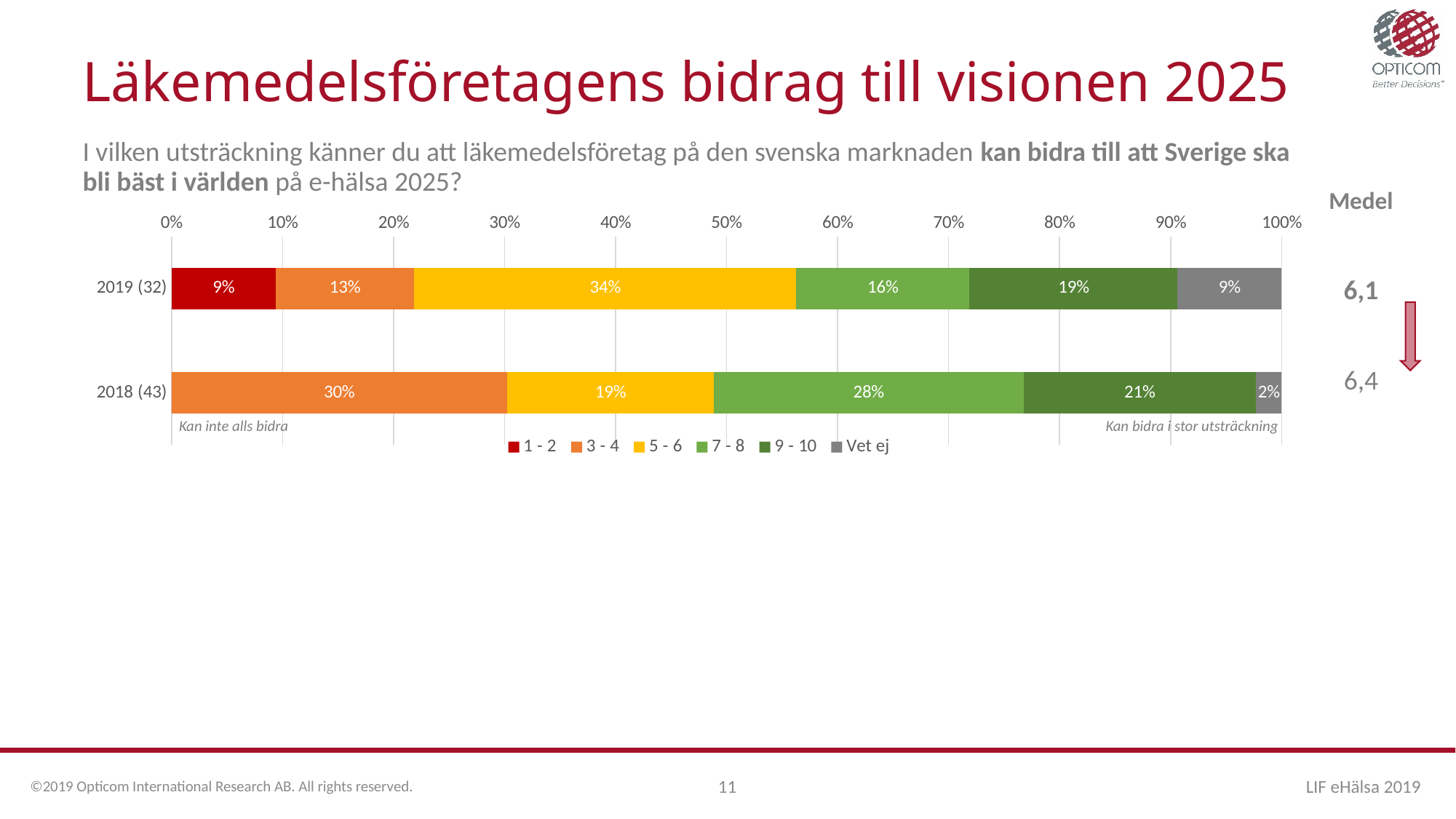
Which year has the larger "3 - 4" segment, 2019 (32) or 2018 (43)? 2018 (43) What is the difference between the "7 - 8" values for 2018 (43) and 2019 (32)? 12% What kind of chart is shown on the slide? Stacked bar chart How many series does the legend list? 6 What is the Medel (mean) value shown for 2019 (32)? 6,1 Which segment is the smallest in the 2018 (43) bar? Vet ej How many categories (years) are plotted on the chart? 2 What is the value of the "3 - 4" segment for 2018 (43)? 30% Which segment is the largest in the 2019 (32) bar? 5 - 6 What is the value of the "5 - 6" segment for 2019 (32)? 34% What is the value of the "9 - 10" segment for 2019 (32)? 19% What is the value of the "Vet ej" segment for 2018 (43)? 2%